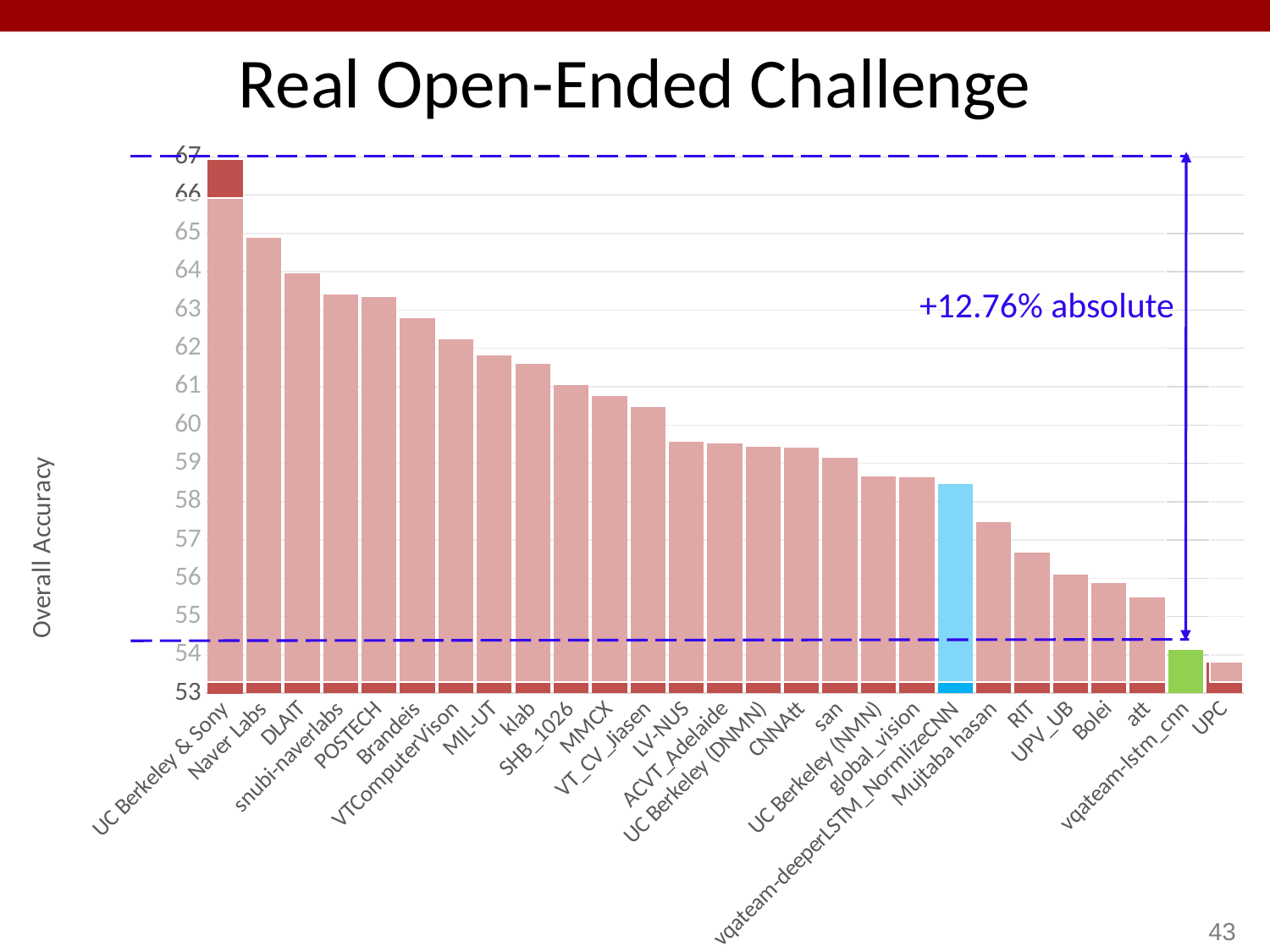
What is the title of the chart? Real Open-Ended Challenge Do the bar values rise or fall from left to right along the x axis? fall What is the label of the y axis? Overall Accuracy Is the overall accuracy for Naver Labs greater or less than 64? greater How many bars (teams) are plotted in the chart? 27 Which has a higher overall accuracy, POSTECH or MIL-UT? POSTECH Which team has the lowest overall accuracy? UPC What absolute improvement is annotated between the top bar and the dashed baseline? +12.76% absolute What kind of chart is shown on the slide? bar chart Is the overall accuracy for vqateam-lstm_cnn greater or less than 55? less Which team has the highest overall accuracy? UC Berkeley & Sony Is the overall accuracy for Mujtaba hasan greater or less than 58? less